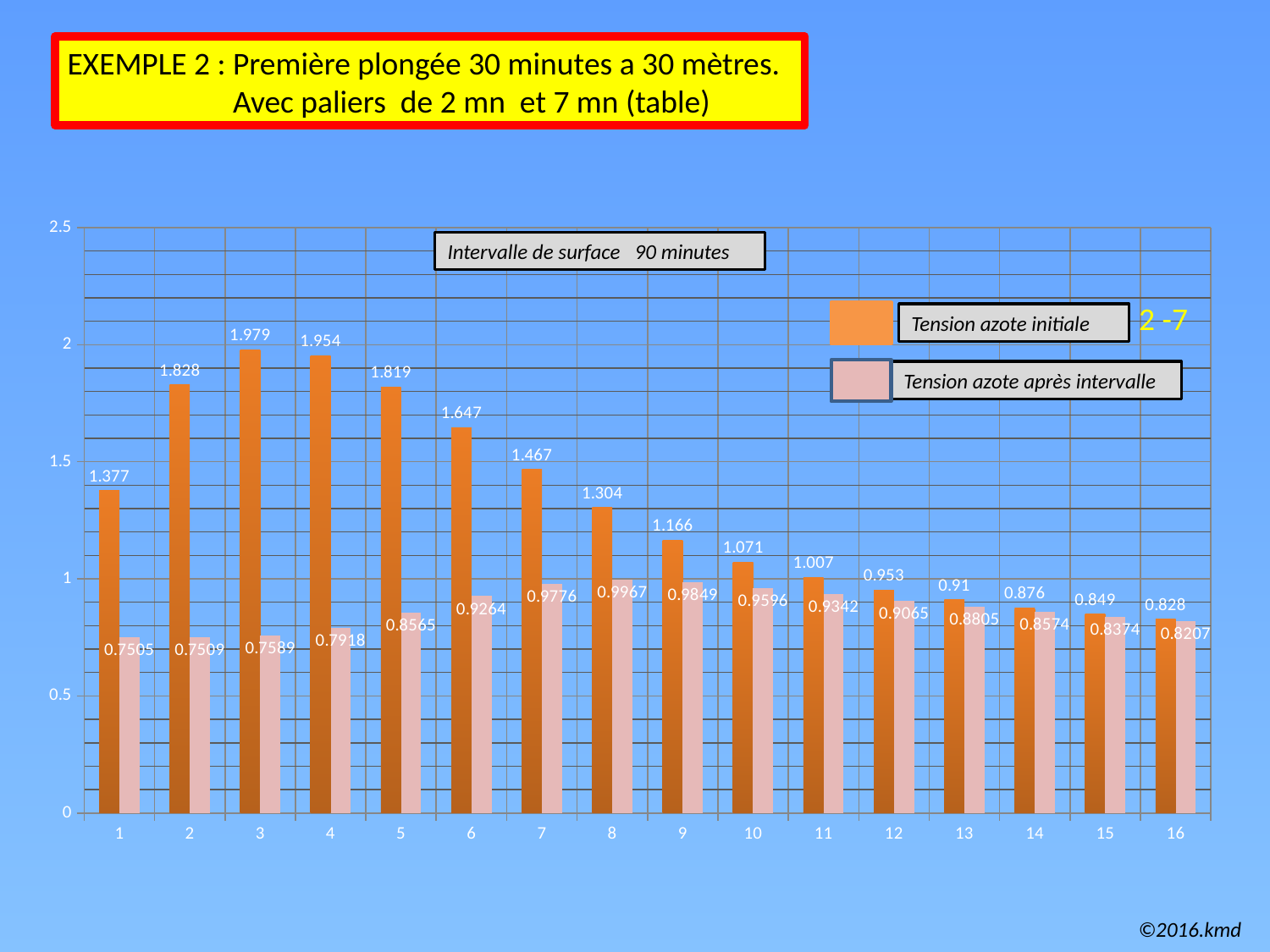
Is the value of "Tension azote initiale" for category 2 greater or less than 1.5? greater Which category has the highest value for "Tension azote initiale"? 3 What is the value of "Tension azote après intervalle" for category 8? 0.9967 What is the value of "Tension azote initiale" for category 10? 1.071 For category 5, which is larger: "Tension azote initiale" or "Tension azote après intervalle"? Tension azote initiale What is the difference between "Tension azote initiale" and "Tension azote après intervalle" for category 1? 0.6265 How many series does the legend list? 2 Which category has the highest value for "Tension azote après intervalle"? 8 Which category has the lowest value for "Tension azote initiale"? 16 How many categories are shown on the x axis? 16 What kind of chart is shown on the slide? bar chart What is the value of "Tension azote initiale" for category 3? 1.979